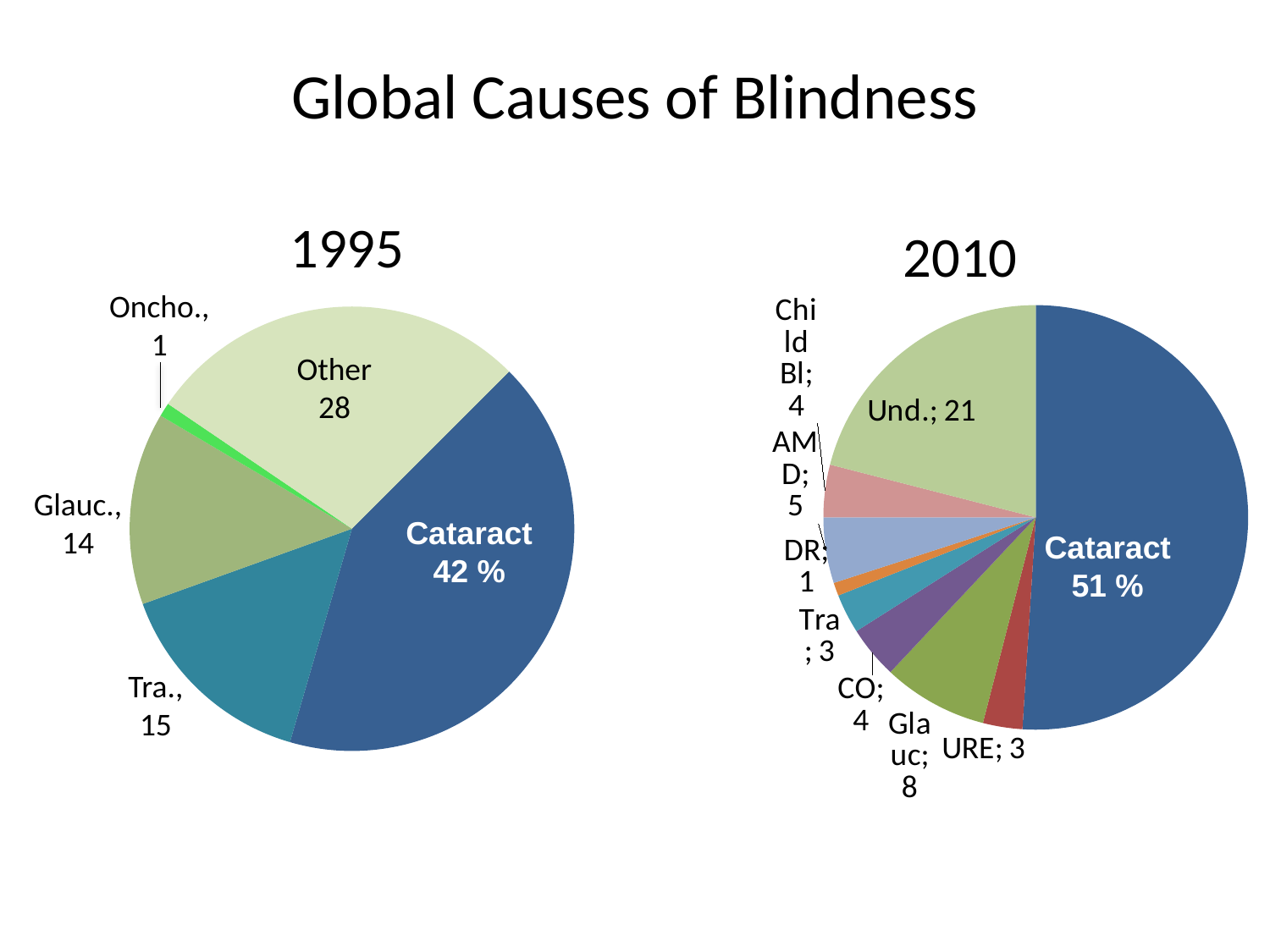
In the 2010 pie chart, what is the value for Und.? 21 In the 2010 pie chart, which is larger, AMD or CO? AMD In the 2010 pie chart, what is the difference between the values for Und. and Glauc? 13 In the 1995 pie chart, what is the value for Tra.? 15 In the 1995 pie chart, which category has the largest slice? Cataract In the 1995 pie chart, what is the value for Glauc.? 14 What kind of chart is used for the 1995 data? Pie chart In the 1995 pie chart, which category has the smallest slice? Oncho. In the 2010 pie chart, what share does Cataract have? 51 % In the 2010 pie chart, which category has the smallest slice? DR How many slices does the 2010 pie chart have? 9 In the 2010 pie chart, what is the value for Glauc? 8